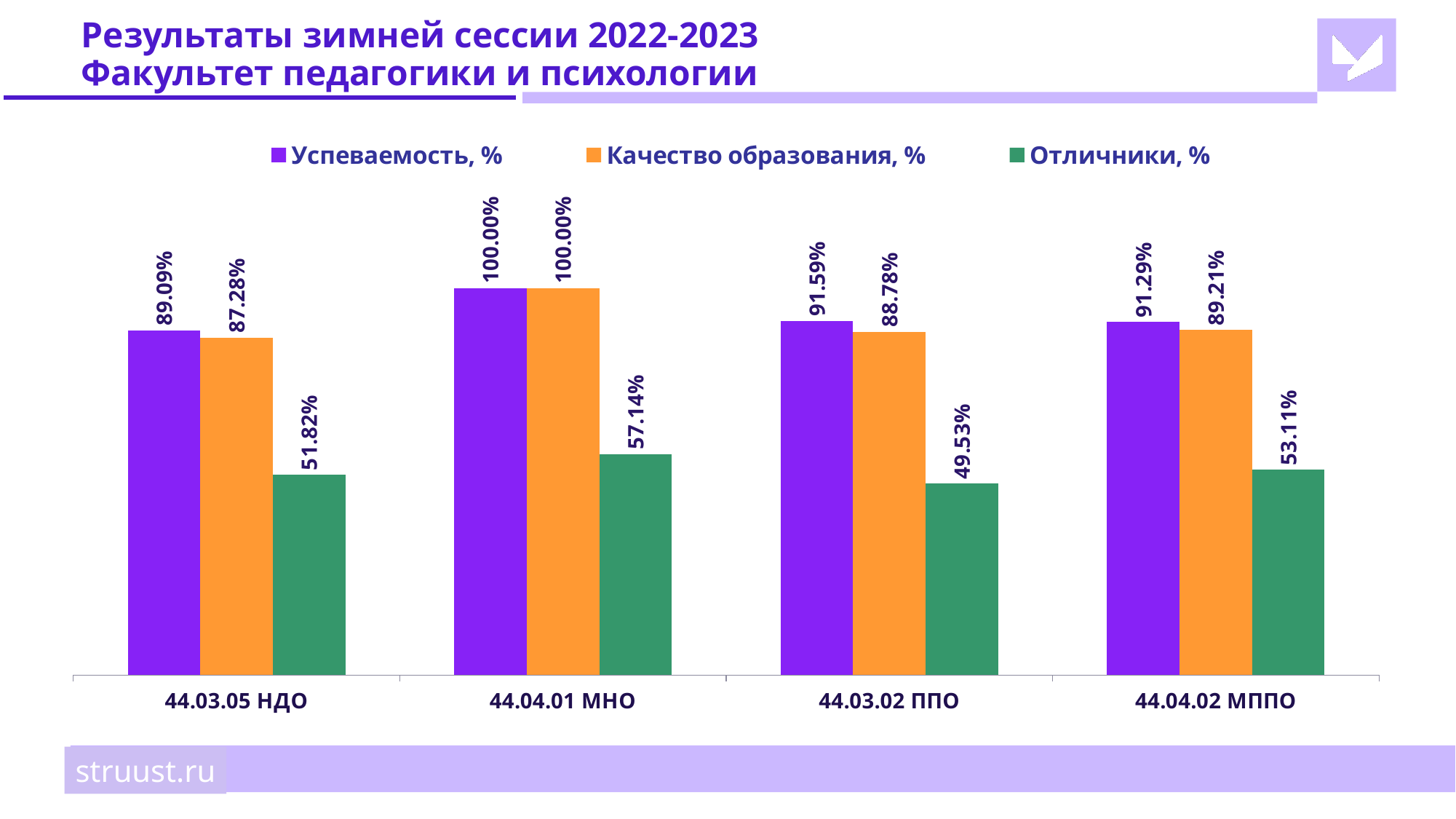
What is the value of Отличники, % for 44.04.02 МППО? 53.11% Which category has the lowest value for Успеваемость, %? 44.03.05 НДО What is the value of Успеваемость, % for 44.03.05 НДО? 89.09% What kind of chart is shown on the slide? Bar chart Which category has the highest value for Отличники, %? 44.04.01 МНО How many series does the legend list? 3 What is the value of Качество образования, % for 44.04.01 МНО? 100.00% What is the difference between Успеваемость, % and Качество образования, % for 44.04.02 МППО? 2.08% Which is larger: Отличники, % for 44.03.05 НДО or for 44.03.02 ППО? 44.03.05 НДО Which colour represents the Отличники, % series? Green What is the value of Качество образования, % for 44.03.02 ППО? 88.78% How many categories are shown on the x axis? 4